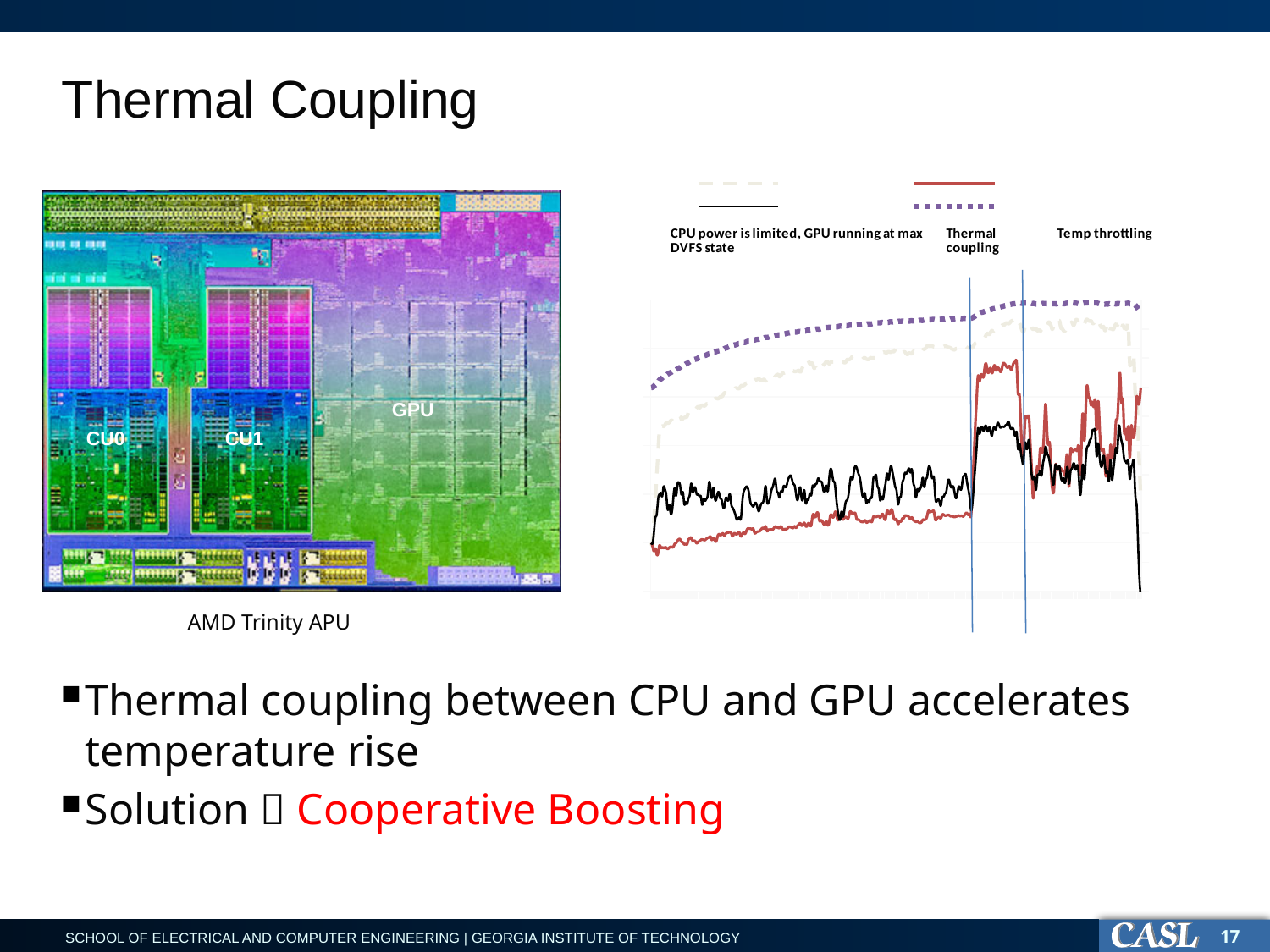
What label is written above the region between the two vertical blue lines on the chart on the right? Thermal coupling How many line styles does the legend of the chart on the right show? 4 In the chart on the right, does the dotted purple line rise or fall along the x axis? rise In the chart on the right, does the solid red line generally rise or fall from the left edge up to the first vertical blue line? rise How many vertical blue marker lines are drawn on the chart on the right? 2 In the chart on the right, which line is higher at the left edge of the plot: the dotted purple line or the solid black line? dotted purple line What kind of chart is shown on the right side of the slide? line chart What label is written above the rightmost region of the chart on the right? Temp throttling In the chart on the right, which line is lower at the left edge of the plot: the solid red line or the dashed beige line? solid red line